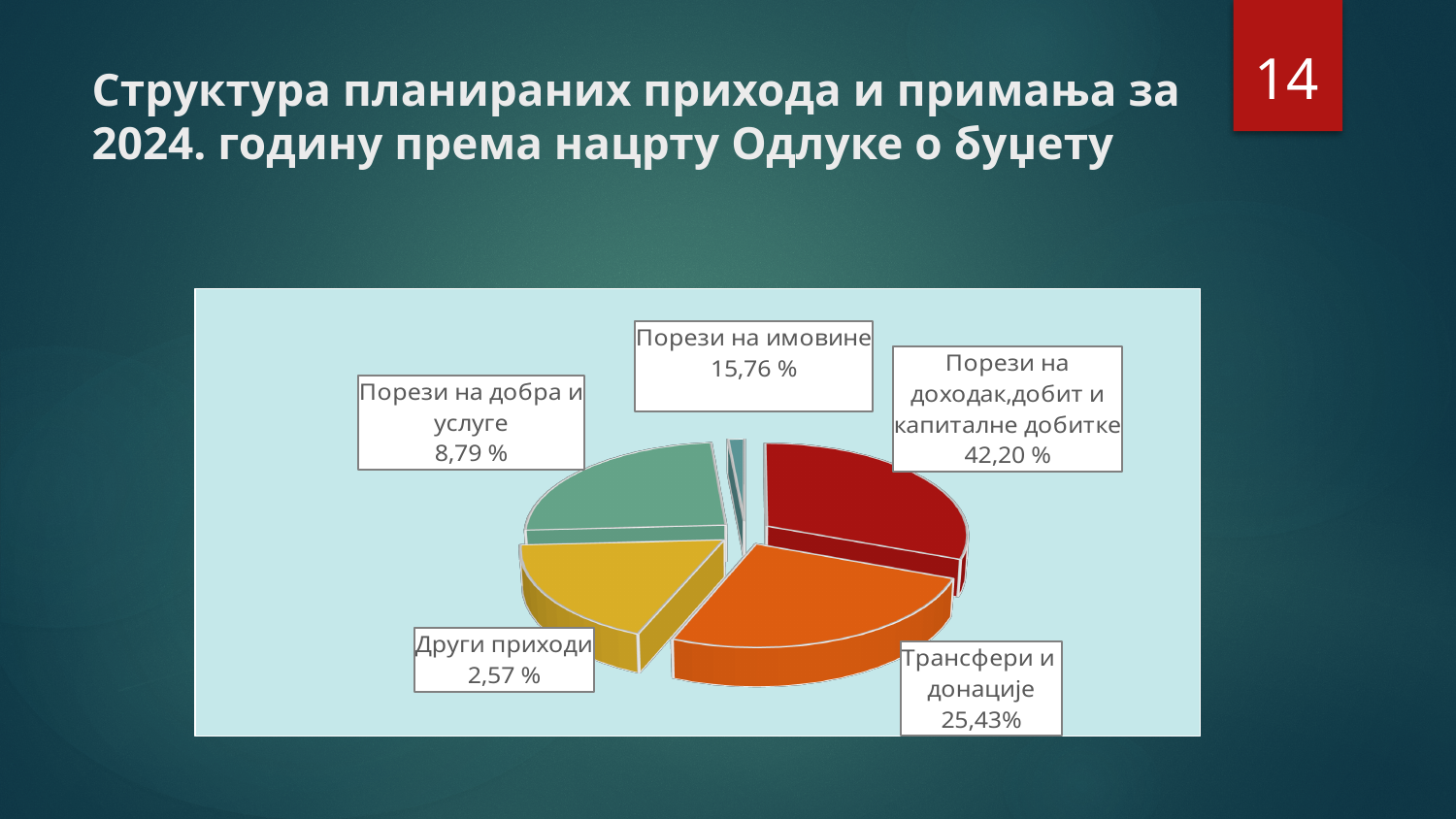
How many slices of the pie have data labels? 5 Which labelled category has the largest share of the pie? Порези на доходак,добит и капиталне добитке What share is shown for Порези на имовине? 15,76 % What kind of chart is shown on the slide? pie chart Which labelled category has the smallest share of the pie? Други приходи What colour is the slice for Трансфери и донације? orange What share is shown for Други приходи? 2,57 % Which is larger: the share for Трансфери и донације or the share for Порези на имовине? Трансфери и донације What share is shown for Порези на добра и услуге? 8,79 % What share is shown for Порези на доходак,добит и капиталне добитке? 42,20 % What is the difference in percentage points between Порези на доходак,добит и капиталне добитке (42,20 %) and Трансфери и донације (25,43%)? 16,77 What share is shown for Трансфери и донације? 25,43%